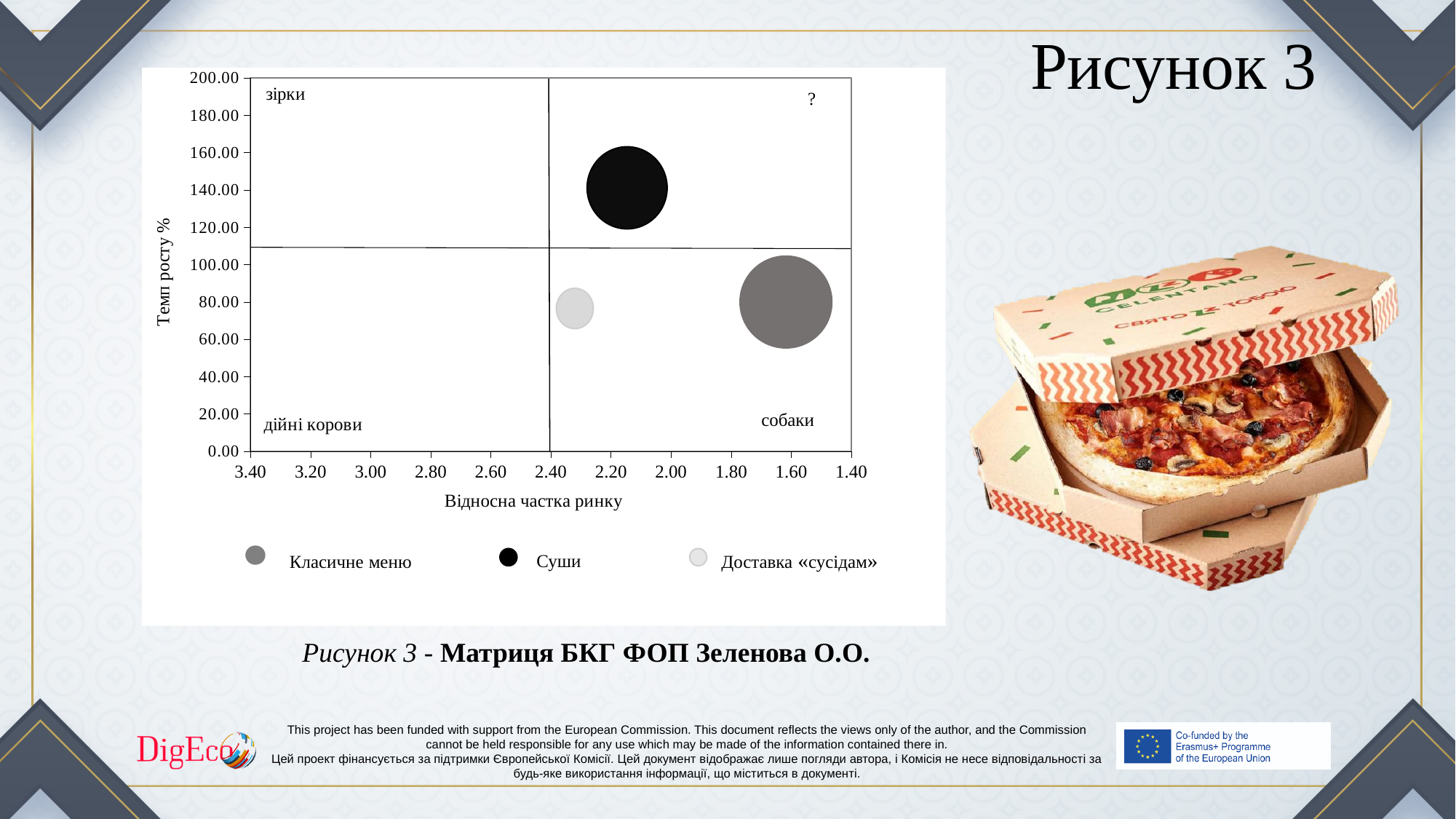
Is the relative market share for Класичне меню greater or less than 1.80? less What kind of chart is shown on the slide? bubble chart Is the relative market share for Суши greater or less than 2.00? greater Is the growth rate (Темп росту %) for Класичне меню greater or less than 100.00? less Which colour represents Суши in the legend? black Which series has the lowest relative market share (Відносна частка ринку)? Класичне меню Which has a higher growth rate, Суши or Класичне меню? Суши Which series has the highest relative market share (Відносна частка ринку)? Доставка «сусідам» Which series has the highest growth rate (Темп росту %)? Суши How many series does the legend list? 3 What is the title of the vertical axis? Темп росту %